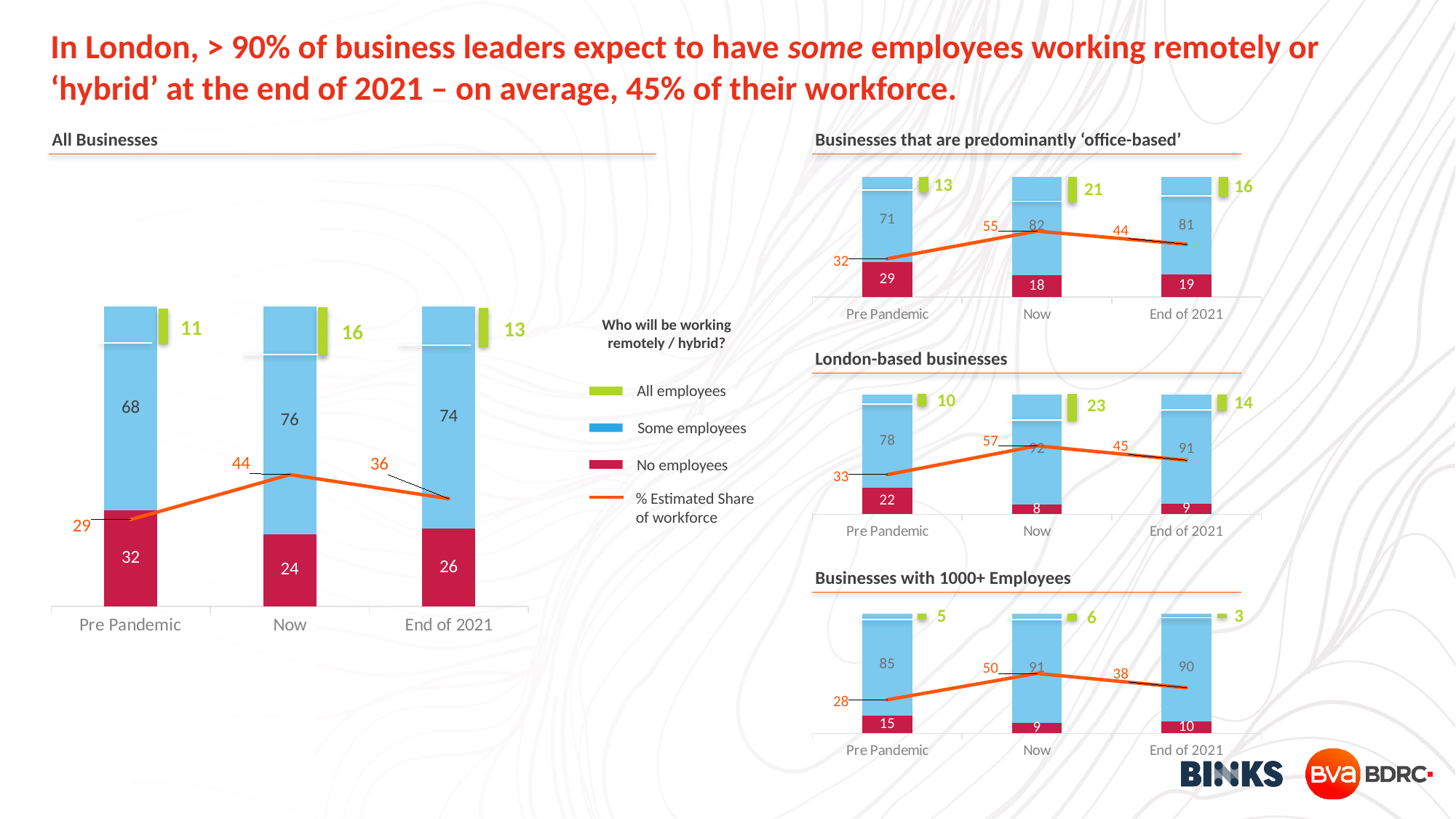
What colour represents All employees in the legend? Green In the 'Businesses that are predominantly office-based' chart, what is the difference between the Some employees values at Now and Pre Pandemic? 11 In the 'London-based businesses' chart, what is the % Estimated Share of workforce at Now? 57 In the 'All Businesses' chart, which period has the highest Some employees value? Now In the 'London-based businesses' chart, which is larger: the No employees value at Pre Pandemic or at End of 2021? Pre Pandemic How many periods are shown on the x axis of the 'All Businesses' chart? 3 How many series does the legend list? 4 In the 'Businesses that are predominantly office-based' chart, what is the All employees value at End of 2021? 16 In the 'All Businesses' chart, what is the value for No employees at Now? 24 In the 'Businesses with 1000+ Employees' chart, does the % Estimated Share of workforce rise or fall from Now to End of 2021? Fall In the 'Businesses with 1000+ Employees' chart, which period has the lowest All employees value? End of 2021 What kind of chart is the 'All Businesses' chart? Stacked bar chart with a line